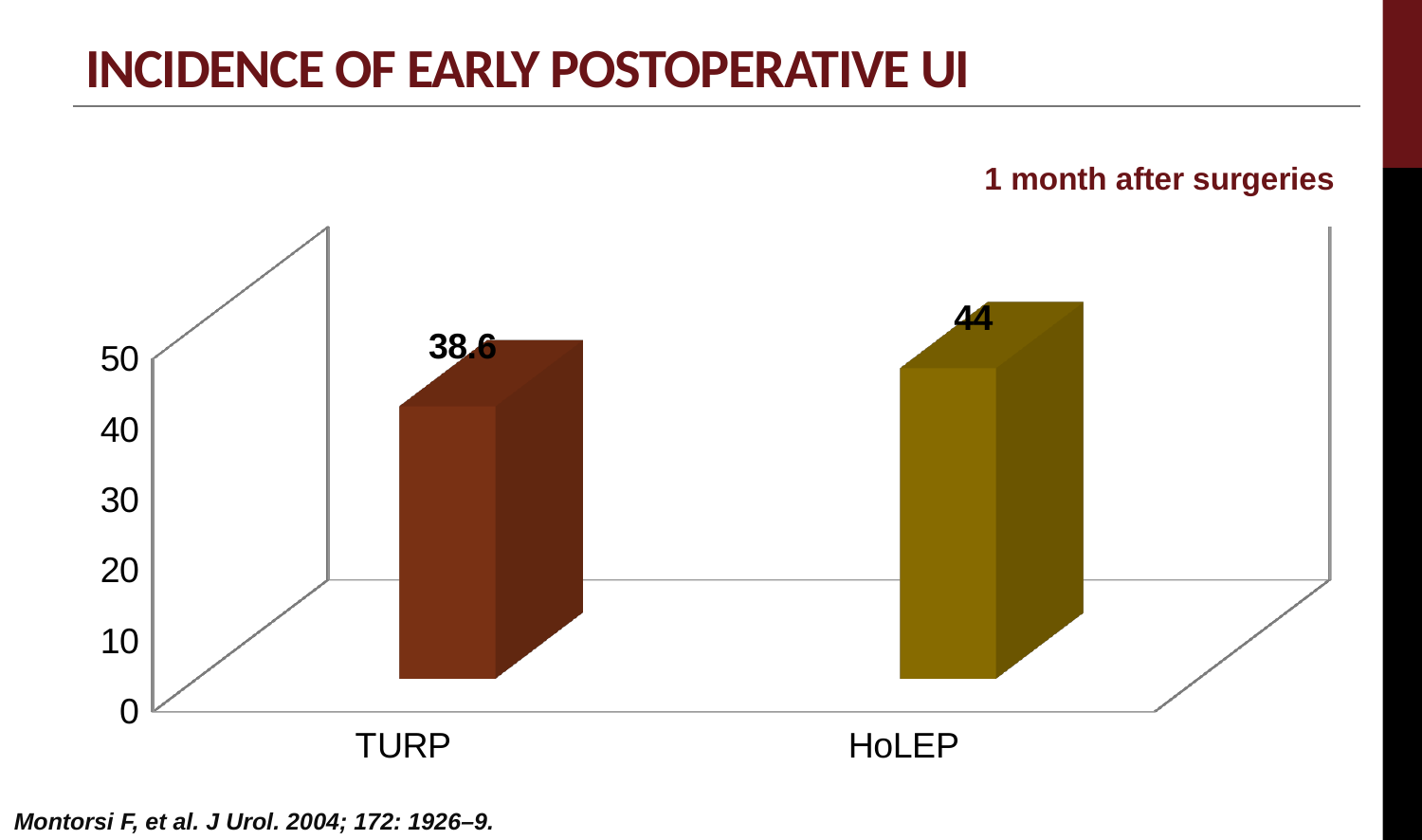
What is the difference between the values for HoLEP and TURP? 5.4 Which category has the lowest value? TURP Which category has the highest value? HoLEP How many categories are shown on the chart? 2 Is the value for TURP greater or less than 40? less What time point does the chart annotation say the data refer to? 1 month after surgeries Which is larger, the value for TURP or the value for HoLEP? HoLEP What is the value for TURP? 38.6 Is the value for HoLEP greater or less than 40? greater What is the title of the slide? INCIDENCE OF EARLY POSTOPERATIVE UI What is the value for HoLEP? 44 What kind of chart is shown on the slide? bar chart